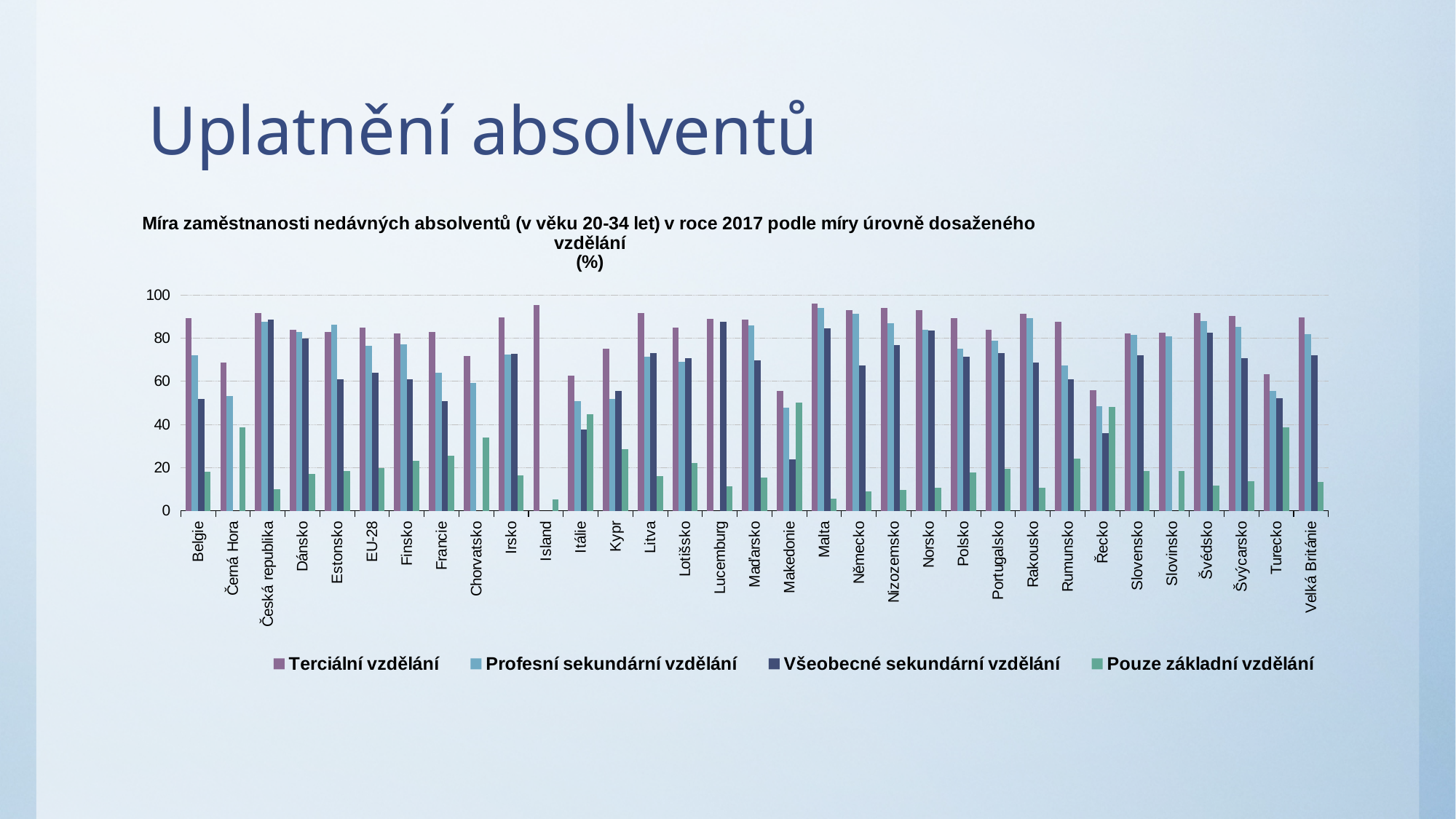
Is the value for Terciální vzdělání in Řecko greater or less than 60? less Is the value for Všeobecné sekundární vzdělání in Lucemburg greater or less than 80? greater What kind of chart is shown on the slide? bar chart Is the value for Pouze základní vzdělání in Makedonie greater or less than 40? greater Which country has the larger value for Terciální vzdělání: Černá Hora or Česká republika? Česká republika How many countries/categories are shown on the x axis? 33 Which series is shown in green in the legend? Pouze základní vzdělání Which country has the larger value for Pouze základní vzdělání: Makedonie or Malta? Makedonie How many series does the legend list? 4 Which is larger for Belgie: Terciální vzdělání or Pouze základní vzdělání? Terciální vzdělání